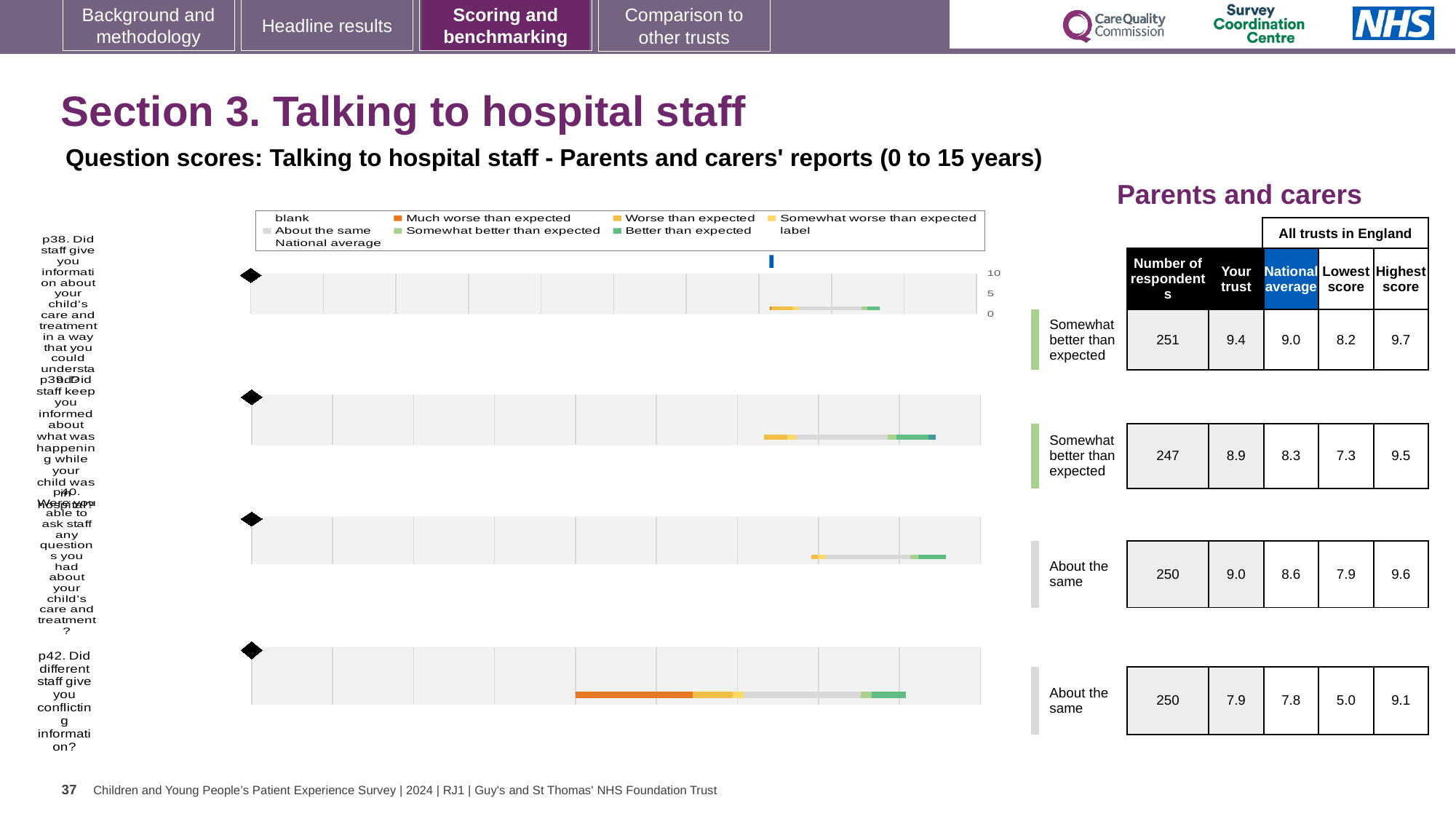
Which chart has a larger orange 'Much worse than expected' segment, the p42 chart or the p40 chart? the p42 chart Which chart has the largest 'Much worse than expected' (orange) segment? the bottom chart (p42) What kind of chart is used to show the question scores on this slide? bar chart Which legend entry is shown in orange? Much worse than expected How many question charts (bars) are shown on the slide? 4 Which question number does the top chart refer to? p38 How many entries does the legend above the charts list? 9